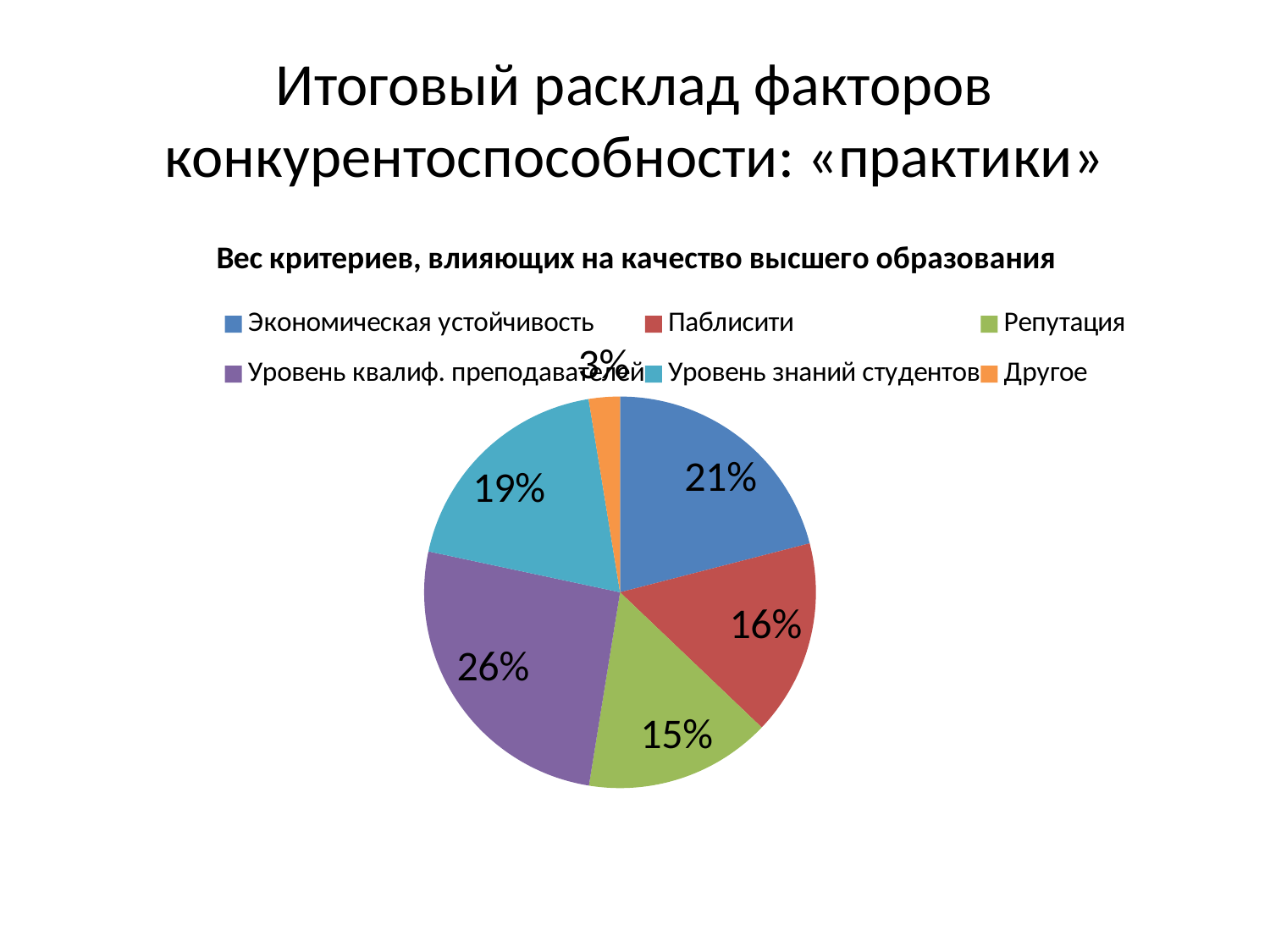
What share of the pie does Уровень знаний студентов have? 19% What share of the pie does Репутация have? 15% Which category has the largest share of the pie? Уровень квалиф. преподавателей What share of the pie does Экономическая устойчивость have? 21% Which is larger, the share of Экономическая устойчивость or the share of Уровень знаний студентов? Экономическая устойчивость What is the title of the chart? Вес критериев, влияющих на качество высшего образования What kind of chart is shown on the slide? pie chart Which category has the smallest share of the pie? Другое What is the difference between the shares of Уровень квалиф. преподавателей and Репутация? 11% How many slices does the pie chart have? 6